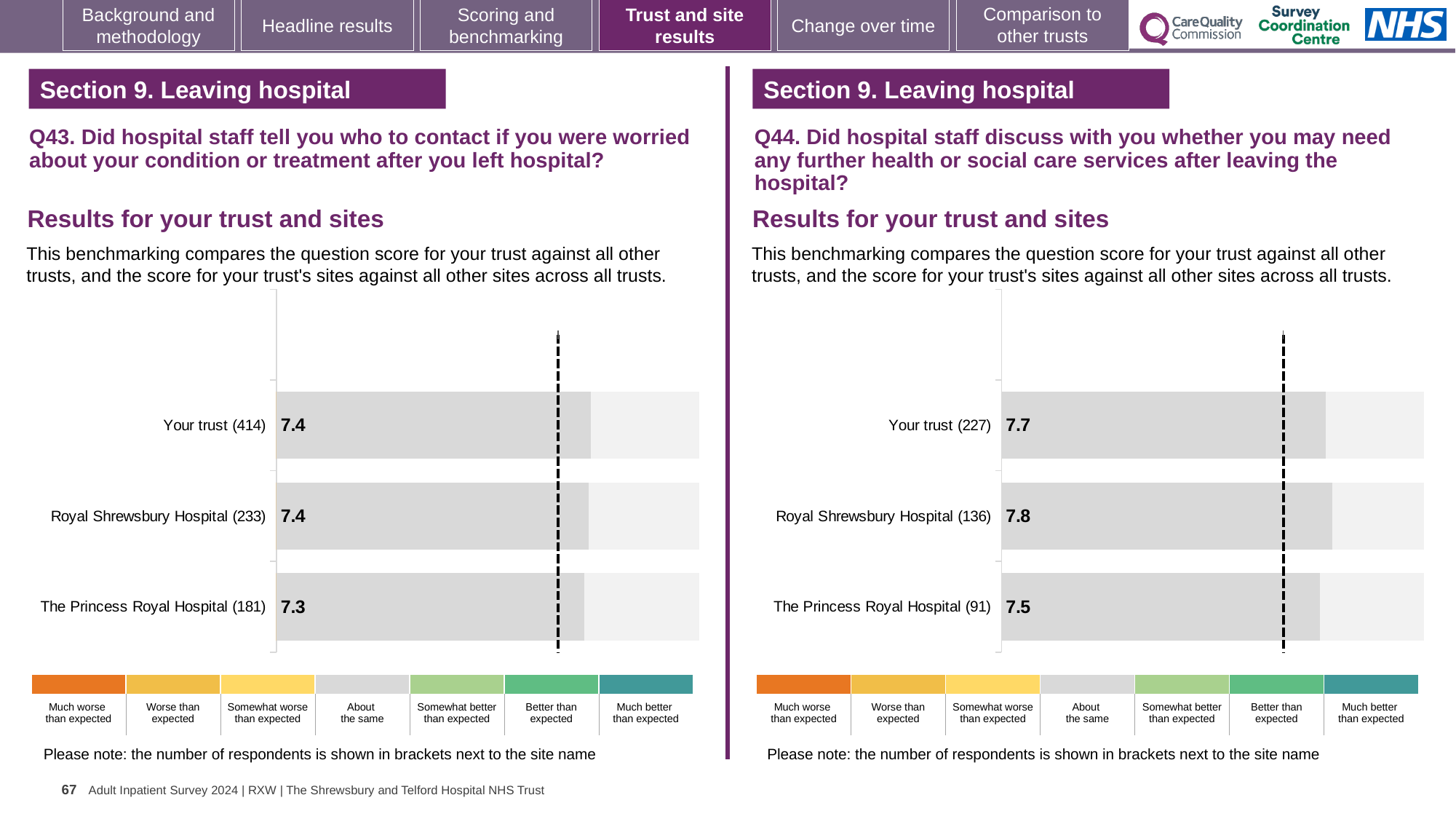
In the Q43 chart on the left, what is the score for Your trust? 7.4 In the Q44 chart on the right, what is the score for The Princess Royal Hospital? 7.5 In the Q43 chart on the left, what is the score for The Princess Royal Hospital? 7.3 In the Q44 chart on the right, is the score for Royal Shrewsbury Hospital larger or smaller than the score for Your trust? larger What kind of chart is used in the Q44 chart on the right? bar chart In the Q44 chart on the right, which site or trust has the lowest score? The Princess Royal Hospital In the Q43 chart on the left, which has the lowest score? The Princess Royal Hospital How many bars are plotted in the Q43 chart on the left? 3 In the Q44 chart on the right, what is the score for Royal Shrewsbury Hospital? 7.8 In the Q43 chart on the left, what is the difference between the scores for Your trust and The Princess Royal Hospital? 0.1 In the Q44 chart on the right, which site or trust has the highest score? Royal Shrewsbury Hospital In the Q44 chart on the right, what is the difference between the scores for Royal Shrewsbury Hospital and The Princess Royal Hospital? 0.3